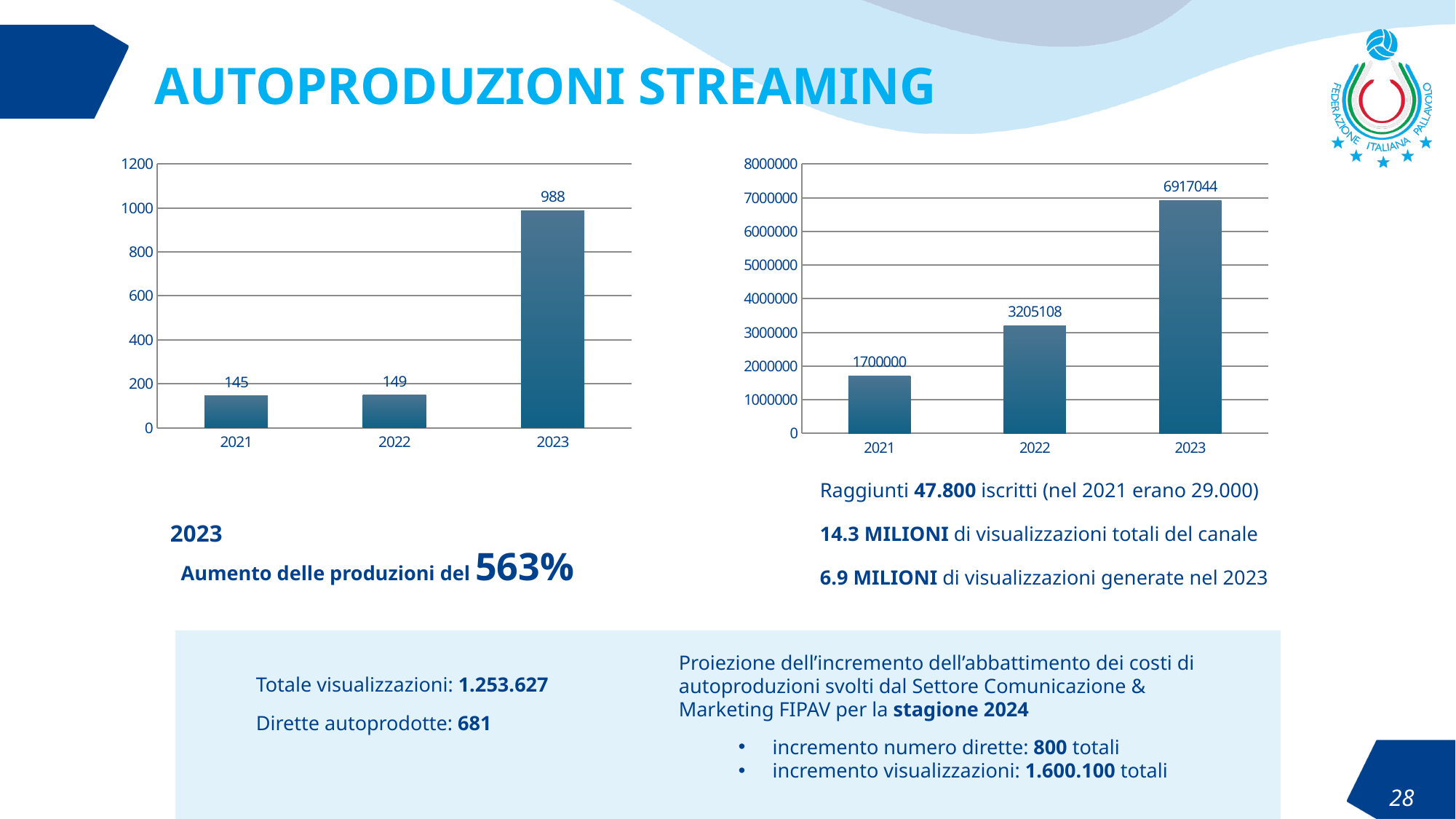
In the left chart, what is the value for 2021? 145 What type of chart is the left chart? Bar chart In the right chart, which year has the lowest value? 2021 In the left chart, which year has the highest value? 2023 How many years are shown on the x axis of the right chart? 3 In the left chart, what is the value for 2023? 988 In the right chart, is the value for 2023 larger than the value for 2022? Yes In the left chart, what is the difference between the values for 2023 and 2022? 839 In the right chart, what is the value for 2023? 6917044 In the left chart, is the value for 2023 greater or less than 800? greater In the right chart, what is the difference between the values for 2022 and 2021? 1505108 In the right chart, what is the value for 2022? 3205108